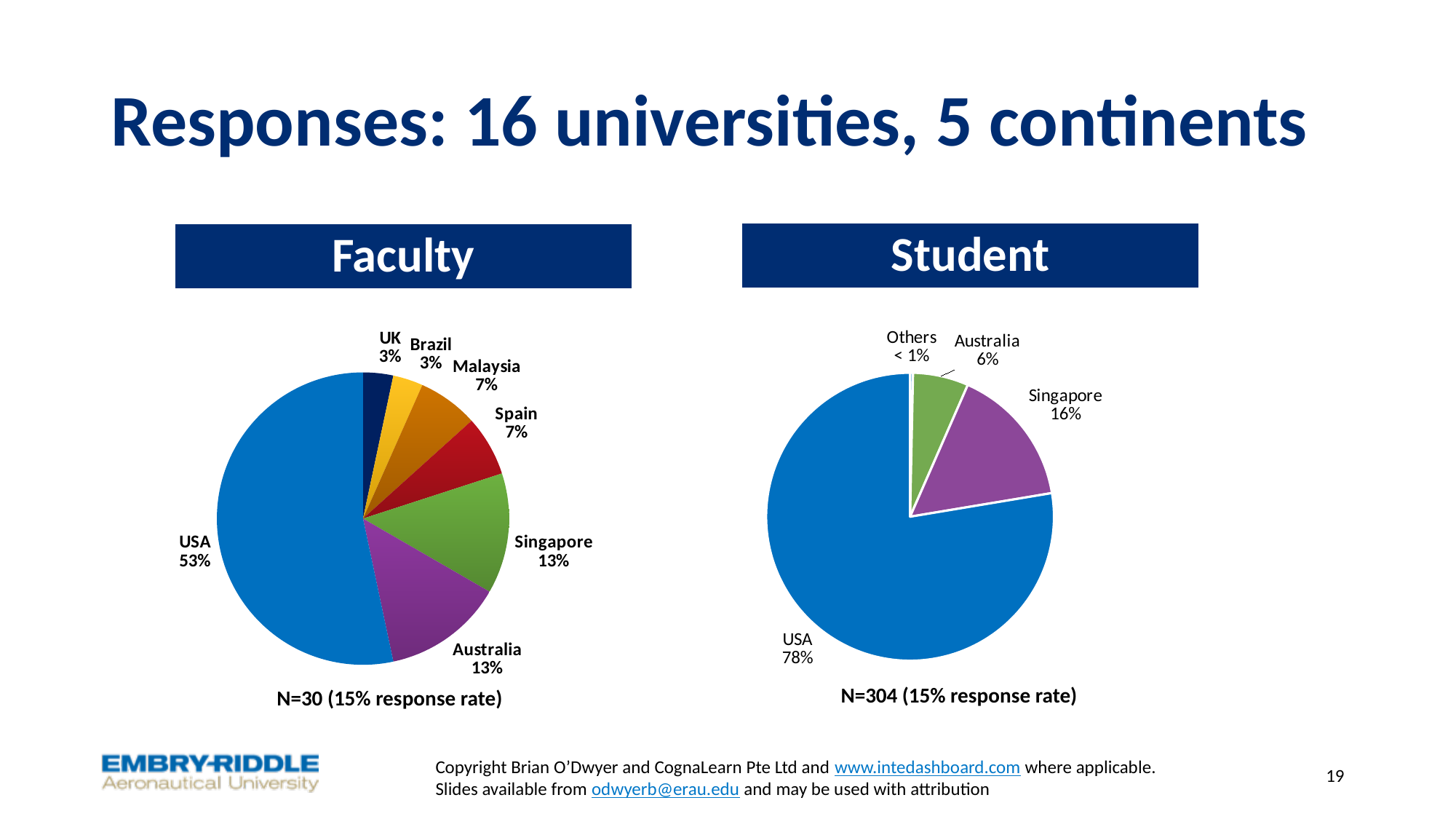
What type of chart is used for the Student responses? Pie chart In the Student pie chart, what share of responses is from Australia? 6% In the Faculty pie chart, which country has the largest share? USA In the Faculty pie chart, what is the difference between the USA share and the Singapore share? 40% In the Student pie chart, what is the difference between the Singapore share and the Australia share? 10% In the Faculty pie chart, what share of responses is from the USA? 53% In the Faculty pie chart, what share of responses is from Malaysia? 7% What is the sample size (N) stated below the Student pie chart? N=304 (15% response rate) In the Student pie chart, which labelled category has the smallest share? Others How many countries or categories are labelled in the Faculty pie chart? 7 In the Student pie chart, what share of responses is from Singapore? 16% In the Faculty pie chart, which is larger: the share for Spain or the share for Australia? Australia